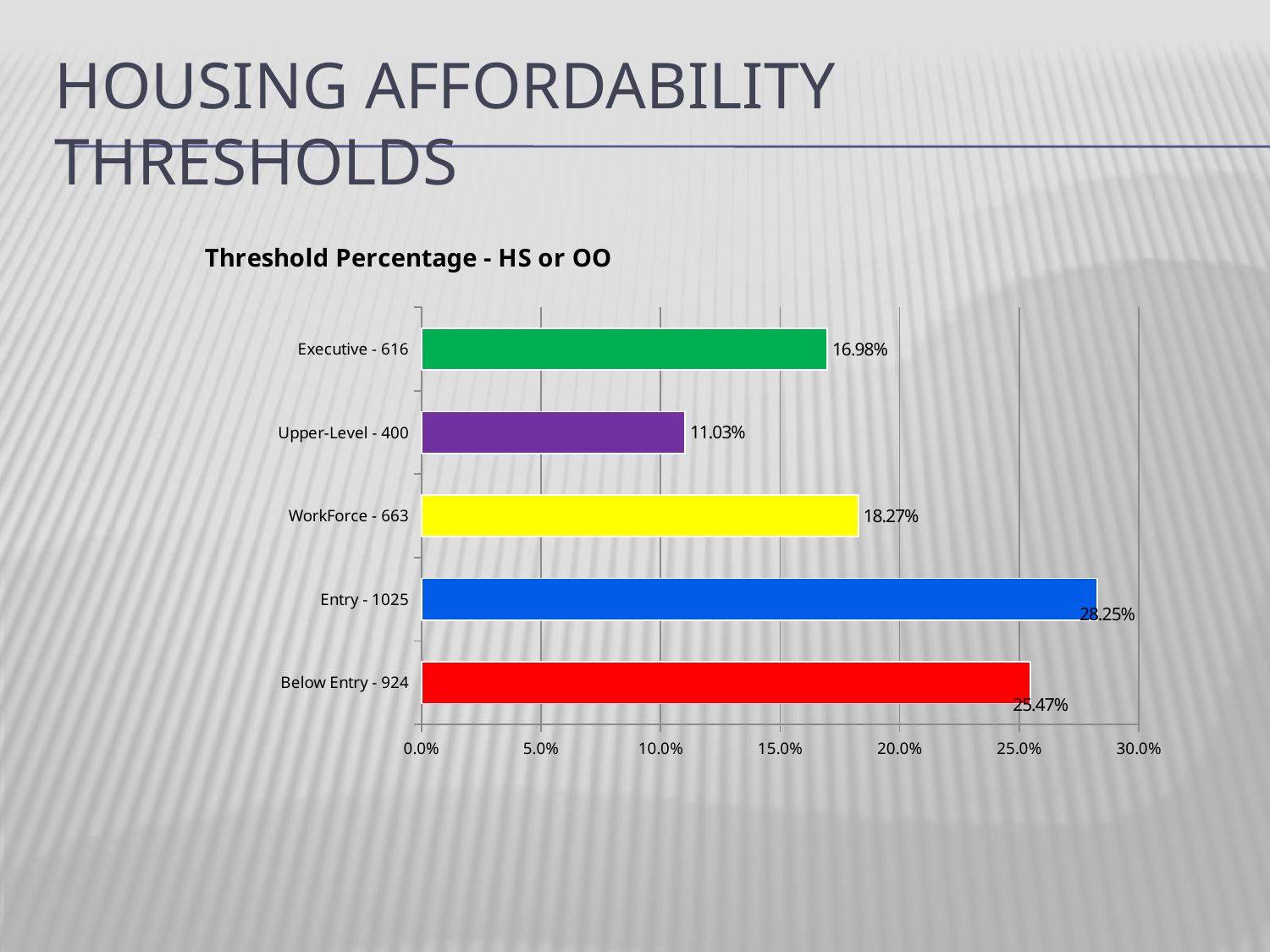
What is the value for Executive - 616? 16.98% What kind of chart is shown on the slide? bar chart How many categories are shown in the chart? 5 What is the value for Upper-Level - 400? 11.03% What is the value for Entry - 1025? 28.25% What is the title of the chart? Threshold Percentage - HS or OO Which category has the lowest value? Upper-Level - 400 What is the difference between the values for Entry - 1025 and Below Entry - 924? 2.78% Which is larger, the value for WorkForce - 663 or the value for Executive - 616? WorkForce - 663 What colour is the bar for Entry - 1025? blue Which category has the highest value? Entry - 1025 Is the value for Below Entry - 924 greater or less than 25.0%? greater